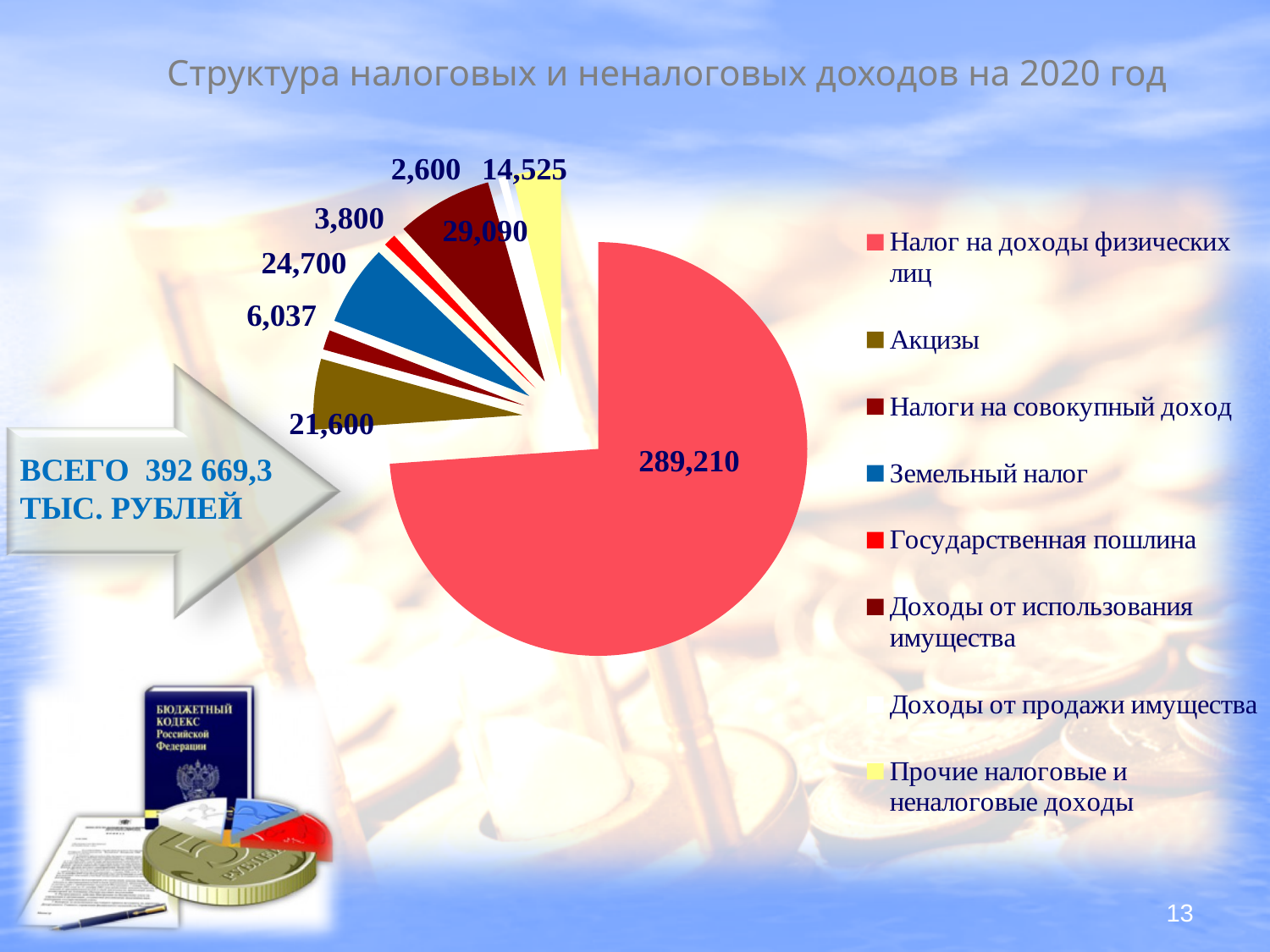
Which category has the largest slice of the pie? Налог на доходы физических лиц Which category has the smallest slice of the pie? Доходы от продажи имущества How many slices does the pie chart have? 8 What is the value for Акцизы? 21,600 What is the value for Налог на доходы физических лиц? 289,210 What is the value for Доходы от использования имущества? 29,090 What is the difference between the values for Земельный налог and Акцизы? 3,100 What is the title of the slide? Структура налоговых и неналоговых доходов на 2020 год What is the value for Прочие налоговые и неналоговые доходы? 14,525 What kind of chart is shown on the slide? pie chart What is the value for Земельный налог? 24,700 Which is larger, the value for Государственная пошлина or the value for Налоги на совокупный доход? Налоги на совокупный доход